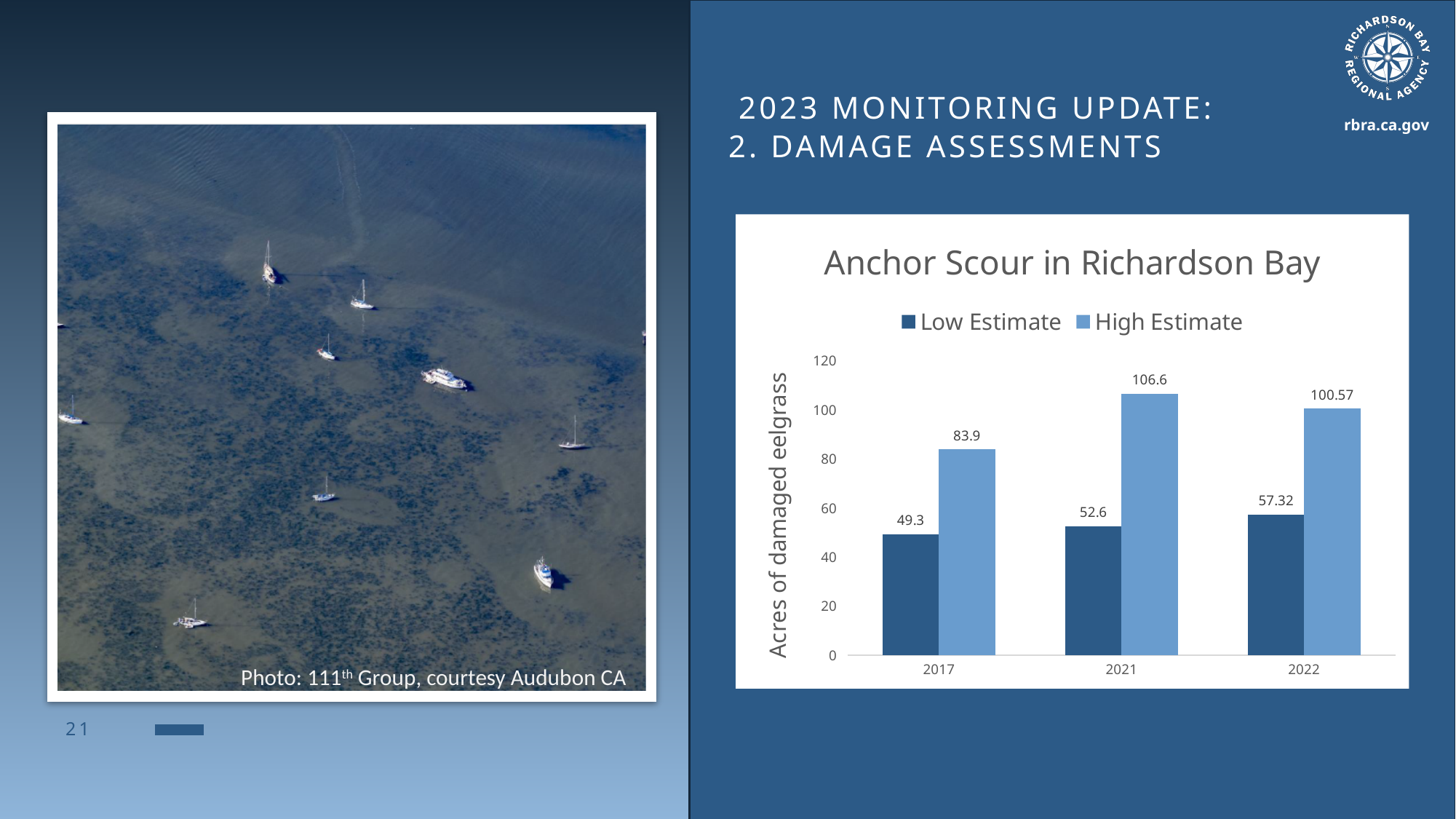
What is the Low Estimate value for 2017? 49.3 What is the High Estimate value for 2022? 100.57 What is the High Estimate value for 2021? 106.6 Which year has the highest High Estimate? 2021 Is the High Estimate for 2017 greater or less than 100? less How many series does the legend list? 2 Which is larger, the Low Estimate for 2022 or the Low Estimate for 2021? Low Estimate for 2022 What is the difference between the High Estimate and Low Estimate for 2017? 34.6 Which year has the lowest Low Estimate? 2017 What is the title of the chart? Anchor Scour in Richardson Bay How many years are shown on the x axis? 3 What kind of chart is shown? bar chart